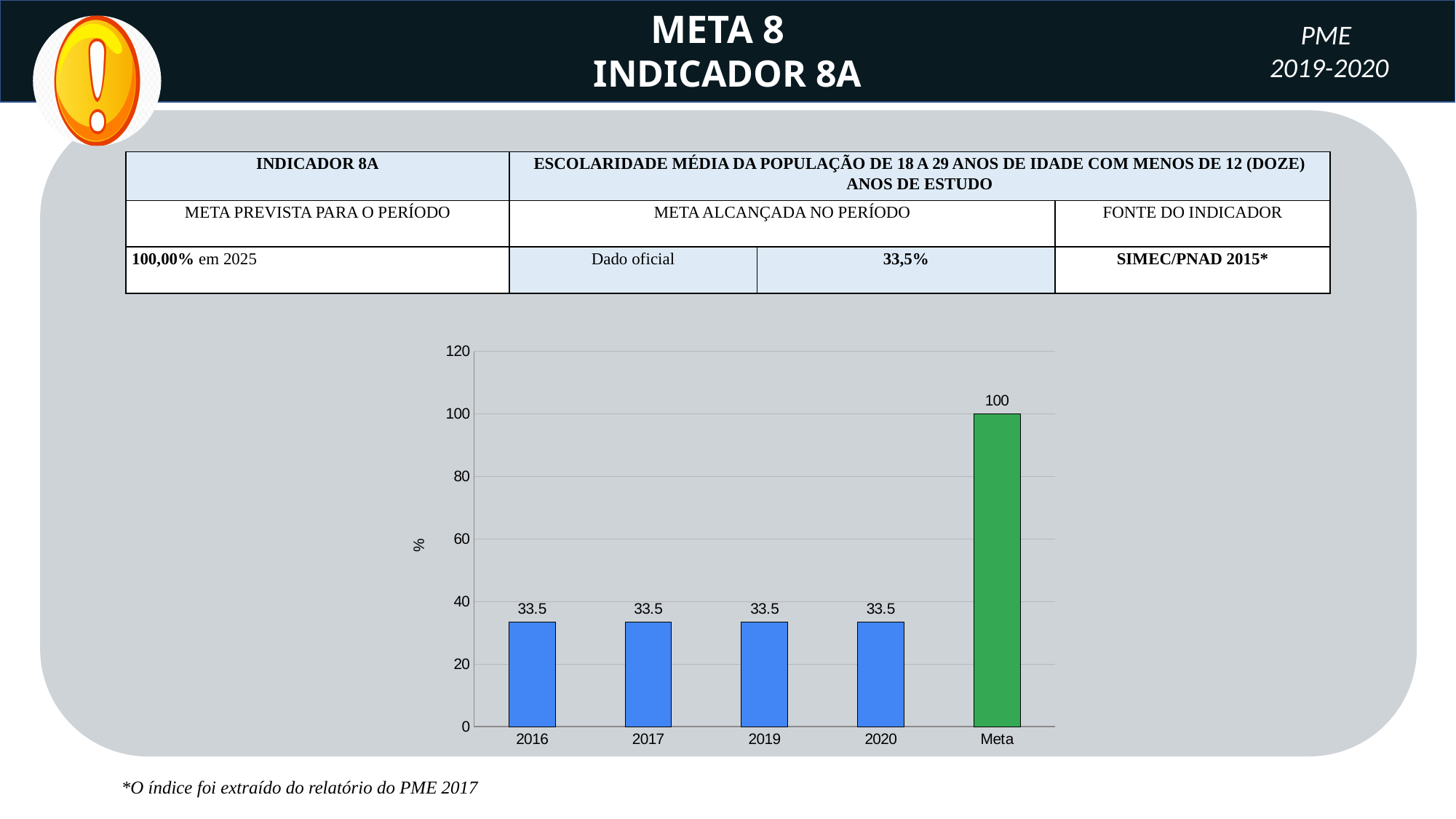
What is the value for 2020 in the chart? 33.5 What is the value for 2016 in the chart? 33.5 Is the value for 2017 greater or less than 40? less Which category has the highest value in the chart? Meta How many bars are shown in the chart? 5 Do the values change from 2016 to 2020 in the chart? No, they stay at 33.5 What is the value for Meta in the chart? 100 Is the value for Meta greater or less than 80? greater What is the label on the vertical axis of the chart? % Which is larger, the value for 2019 or the value for Meta? Meta What is the difference between the Meta value and the 2020 value? 66.5 What kind of chart is shown on the slide? bar chart